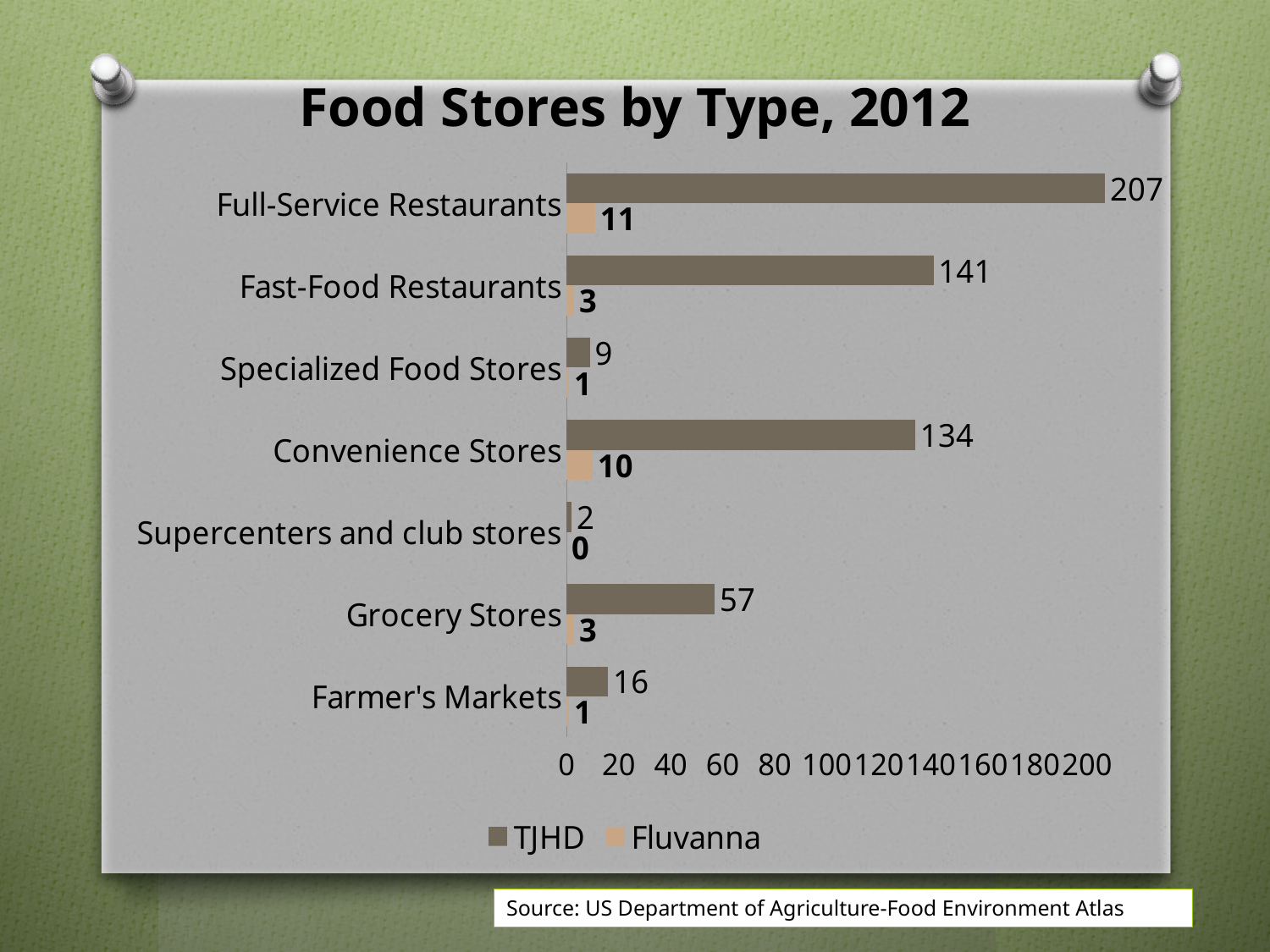
What is the Fluvanna value for Convenience Stores? 10 Which category has the highest TJHD value? Full-Service Restaurants What is the difference between the TJHD values for Fast-Food Restaurants and Convenience Stores? 7 Which category has the highest Fluvanna value? Full-Service Restaurants What is the TJHD value for Grocery Stores? 57 How many series does the legend list? 2 What is the TJHD value for Full-Service Restaurants? 207 Which is larger, the TJHD value for Farmer's Markets or for Specialized Food Stores? Farmer's Markets What kind of chart is shown on the slide? Bar chart How many categories are shown on the chart? 7 What is the title of the chart? Food Stores by Type, 2012 Which category has the lowest TJHD value? Supercenters and club stores